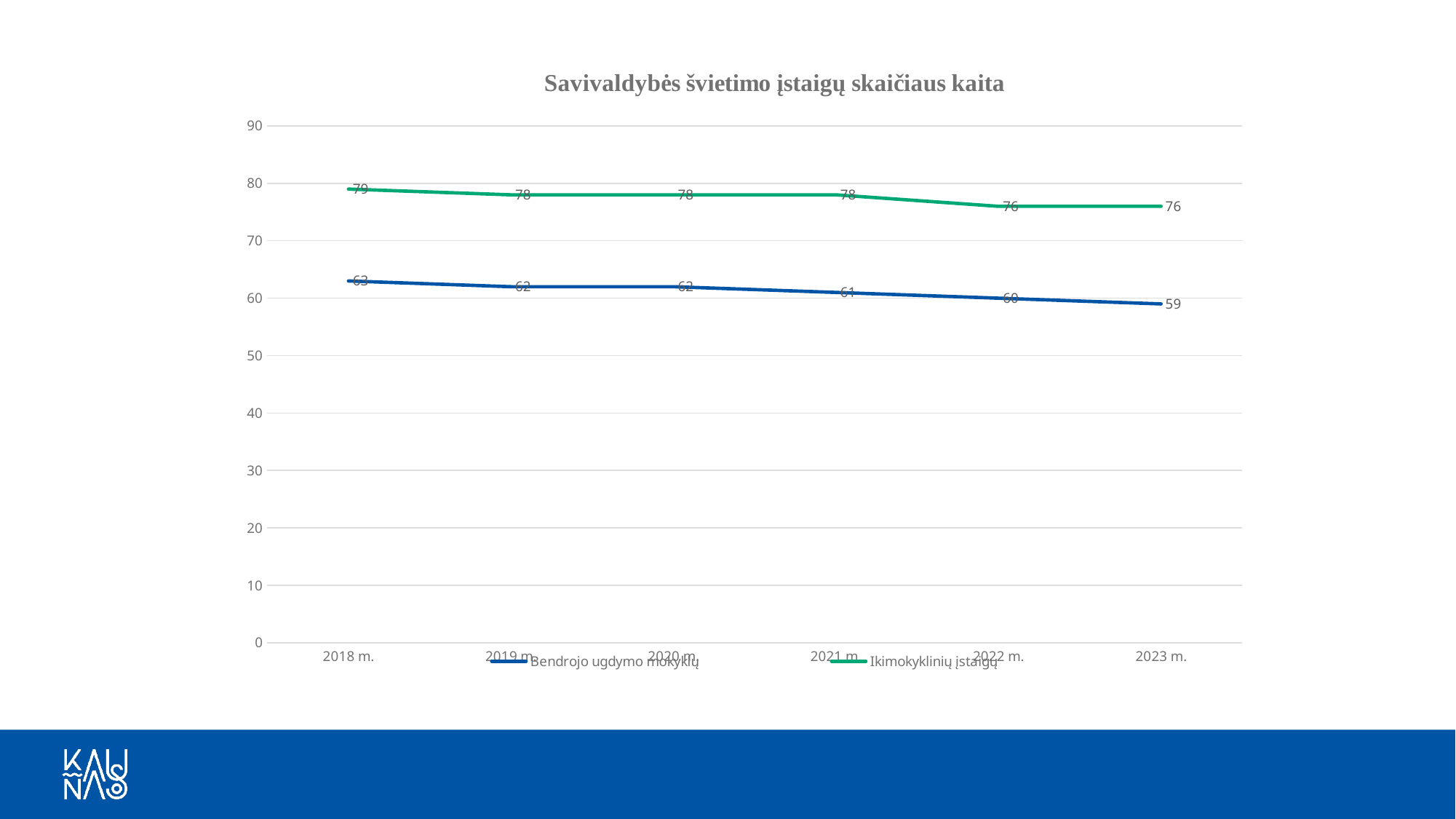
In which year is the value for Bendrojo ugdymo mokyklų the lowest? 2023 m. What is the difference between the Ikimokyklinių įstaigų and Bendrojo ugdymo mokyklų values in 2023 m.? 17 What type of chart is shown on the slide? line chart What is the value for Ikimokyklinių įstaigų in 2018 m.? 79 Does the Bendrojo ugdymo mokyklų series rise or fall from 2018 m. to 2023 m.? fall How many series does the legend list? 2 What is the title of the chart? Savivaldybės švietimo įstaigų skaičiaus kaita What is the value for Ikimokyklinių įstaigų in 2022 m.? 76 What is the value for Bendrojo ugdymo mokyklų in 2023 m.? 59 What is the value for Bendrojo ugdymo mokyklų in 2021 m.? 61 In which year is the value for Ikimokyklinių įstaigų the highest? 2018 m. How many years are shown on the x axis? 6